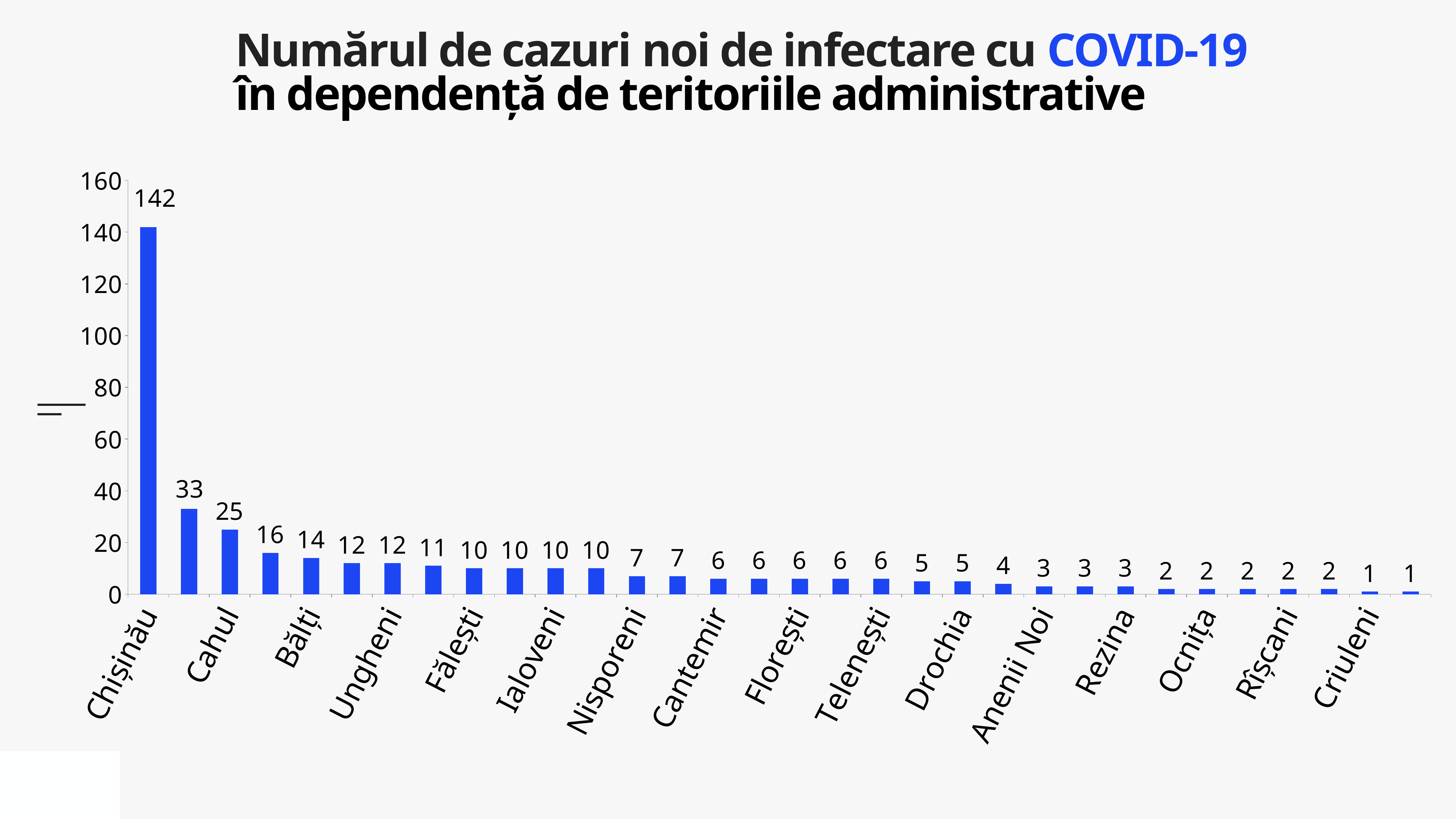
What is the difference between the tallest bar (142) and the second-tallest bar (33)? 109 What is the value of the tallest bar? 142 What is the smallest value shown on any bar? 1 Is the value for Chișinău greater or less than 140? greater Which is larger, the value for Chișinău or the value for Cahul? Chișinău How many bars are plotted in the chart? 32 Which category has the highest value? Chișinău What colour are the bars in the chart? blue What is the value of the second-tallest bar? 33 Do the values rise or fall from left to right along the x axis? fall What kind of chart is shown on the slide? bar chart What is the value for Chișinău? 142